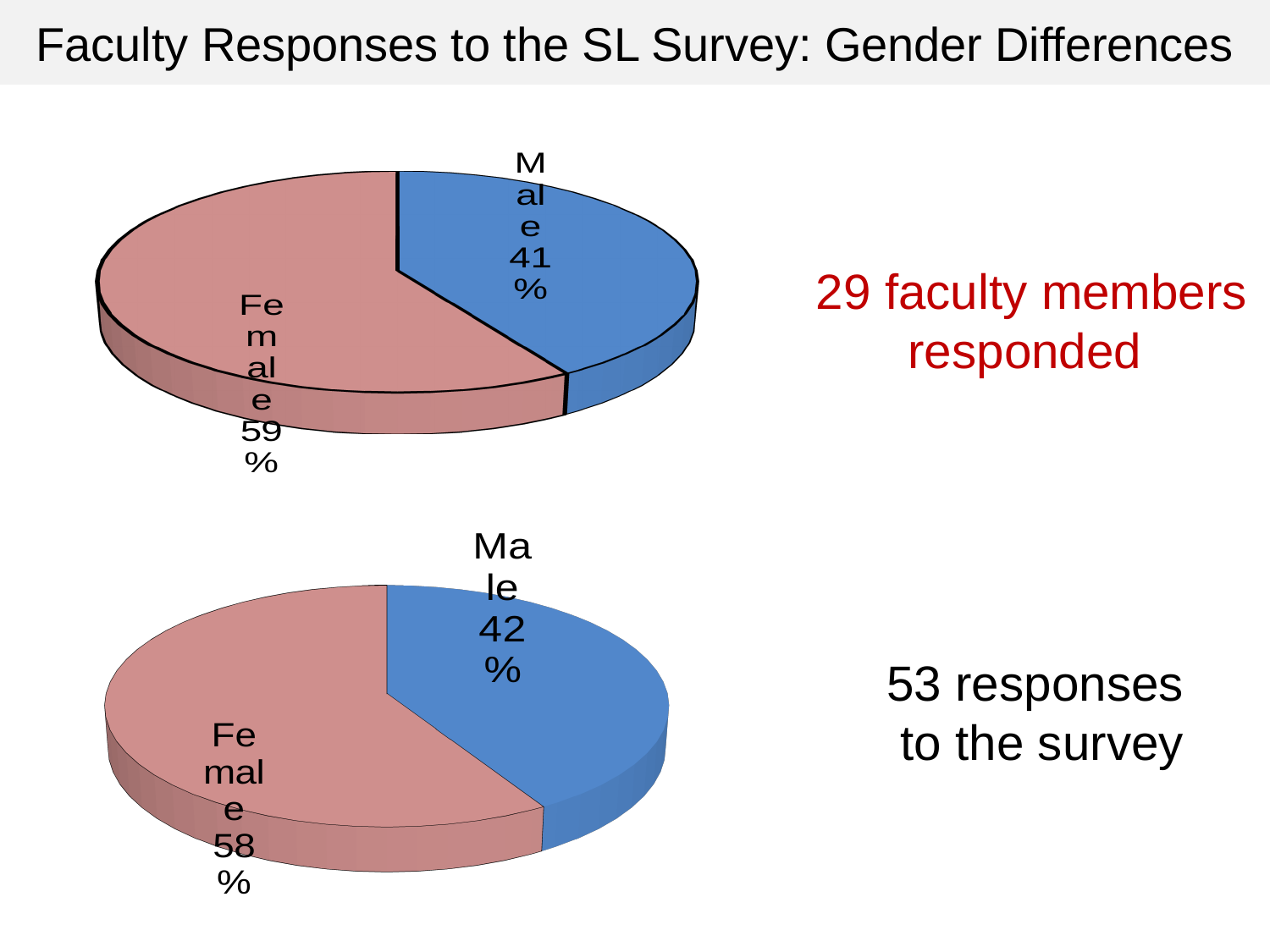
In the top pie chart, what percentage of respondents are Male? 41% In the bottom pie chart, which slice is the smallest? Male In the bottom pie chart, what percentage of respondents are Male? 42% In the bottom pie chart, which is larger, the Female slice or the Male slice? Female In the top pie chart, what is the difference between the Female and Male percentages? 18% What type of chart is the bottom chart? Pie chart In the top pie chart, what percentage of respondents are Female? 59% In the bottom pie chart, what percentage of respondents are Female? 58% In the top pie chart, what colour is the Male slice? Blue In the bottom pie chart, what is the difference between the Female and Male percentages? 16% How many slices does the top pie chart have? 2 In the top pie chart, which slice is the largest? Female